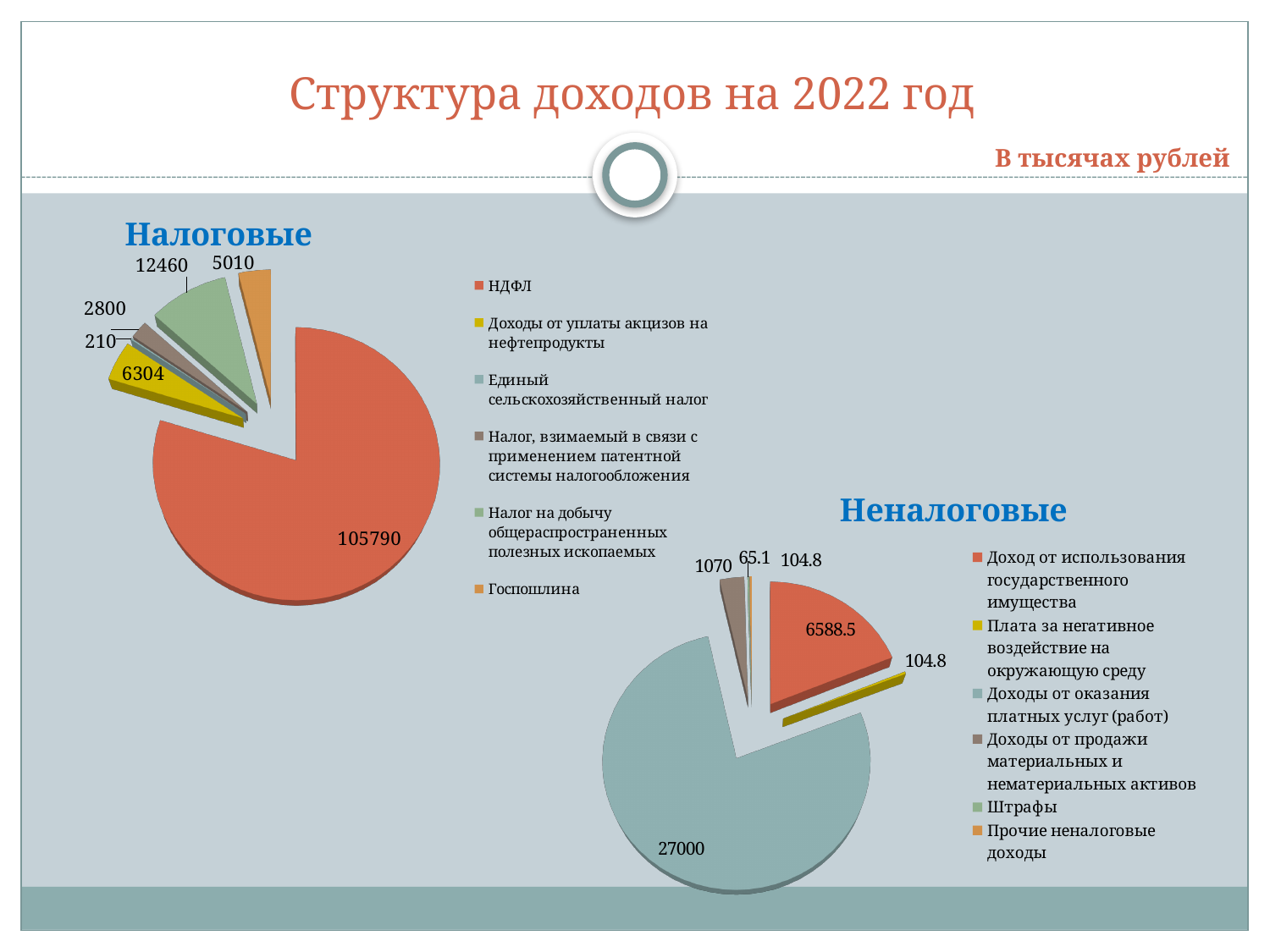
What unit is stated for the values on the slide? В тысячах рублей In the "Налоговые" chart, what is the value for Госпошлина? 5010 In the "Неналоговые" chart, what is the value for Штрафы? 65.1 In the "Налоговые" chart, which category has the smallest value? Единый сельскохозяйственный налог In the "Налоговые" chart, what is the difference between Налог на добычу общераспространенных полезных ископаемых and Доходы от уплаты акцизов на нефтепродукты? 6156 What type of chart is the "Налоговые" chart? pie chart How many categories does the "Налоговые" chart show? 6 In the "Неналоговые" chart, which is larger: Доход от использования государственного имущества or Доходы от продажи материальных и нематериальных активов? Доход от использования государственного имущества In the "Неналоговые" chart, what is the value for Доходы от оказания платных услуг (работ)? 27000 In the "Неналоговые" chart, what is the difference between Доходы от оказания платных услуг (работ) and Доход от использования государственного имущества? 20411.5 In the "Налоговые" chart, what is the value for НДФЛ? 105790 In the "Неналоговые" chart, which category has the largest value? Доходы от оказания платных услуг (работ)